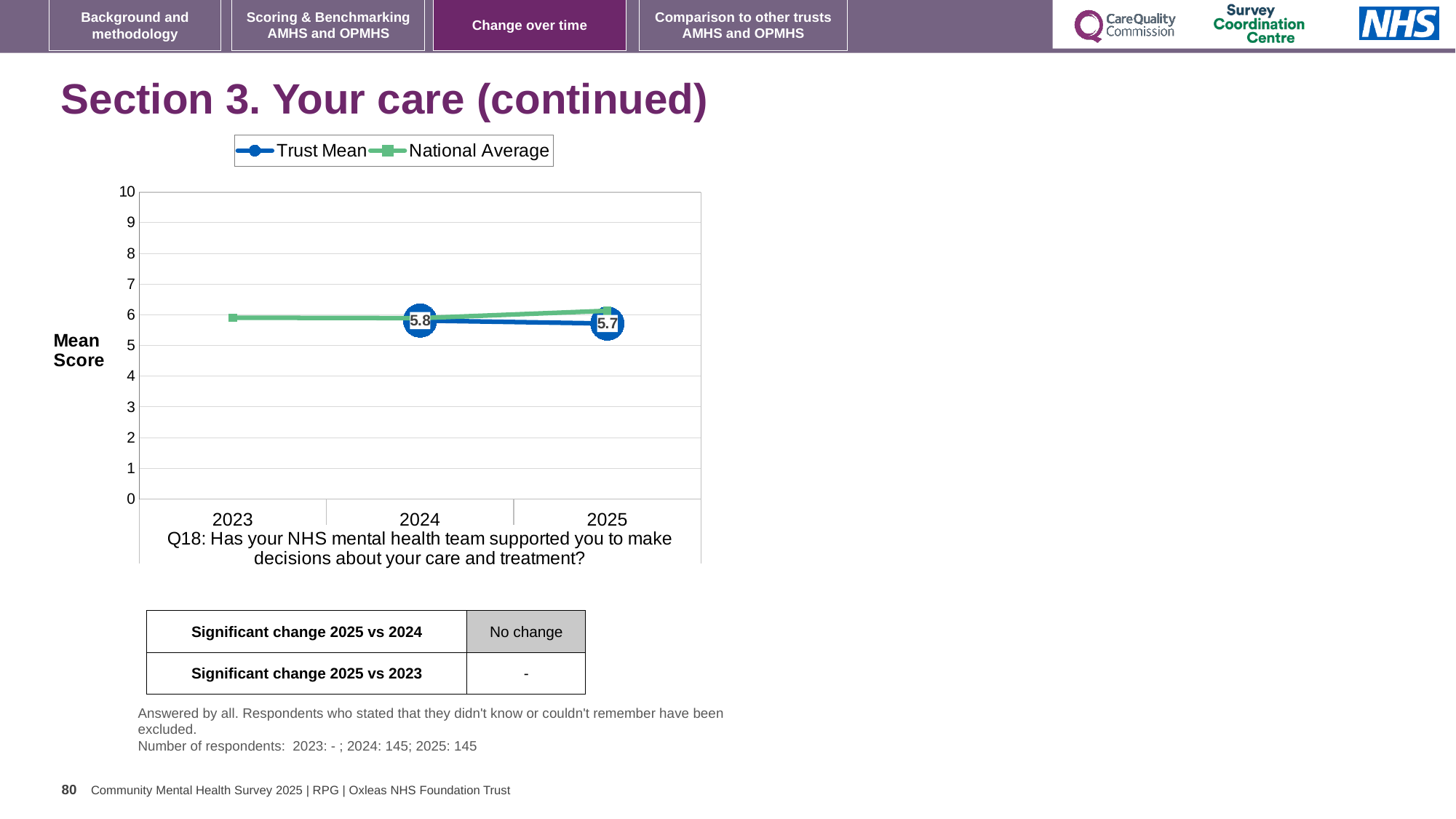
Does the Trust Mean rise or fall from 2024 to 2025? fall What are the two series named in the legend? Trust Mean and National Average Which year has the higher Trust Mean value, 2024 or 2025? 2024 What is the Trust Mean value for 2024? 5.8 How many years are shown on the x axis? 3 In 2025, which is higher, the Trust Mean or the National Average? National Average How many series does the legend list? 2 What is the Trust Mean value for 2025? 5.7 What is the difference between the Trust Mean values for 2024 and 2025? 0.1 What kind of chart is shown on the slide? line chart Is the National Average value for 2023 greater or less than 7? less Is the National Average value for 2025 greater or less than 5? greater